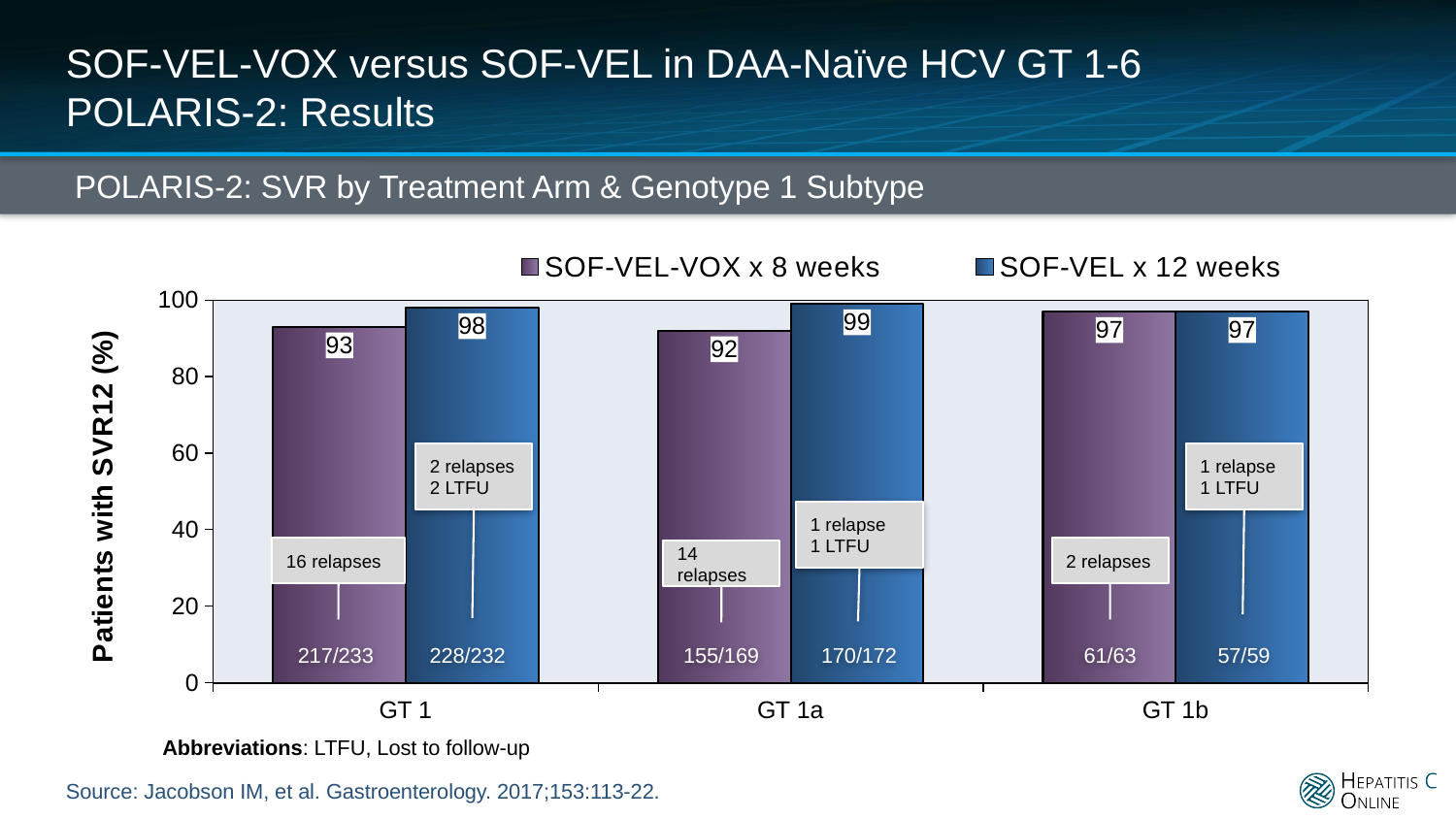
How many series does the legend list? 2 Which genotype subtype has the highest SVR12 rate for SOF-VEL x 12 weeks? GT 1a What is the SVR12 rate for SOF-VEL-VOX x 8 weeks in GT 1? 93 Which genotype subtype has the lowest SVR12 rate for SOF-VEL-VOX x 8 weeks? GT 1a What kind of chart is shown on the slide? Bar chart What fraction of patients achieved SVR12 with SOF-VEL x 12 weeks in GT 1? 228/232 In GT 1, which treatment arm has the higher SVR12 rate? SOF-VEL x 12 weeks What is the SVR12 rate for SOF-VEL x 12 weeks in GT 1a? 99 How many genotype subtype categories are shown on the x axis? 3 What is the difference in SVR12 rate between SOF-VEL x 12 weeks and SOF-VEL-VOX x 8 weeks in GT 1a? 7 What is the SVR12 rate for SOF-VEL-VOX x 8 weeks in GT 1b? 97 How many relapses are noted for the SOF-VEL-VOX x 8 weeks arm in GT 1? 16 relapses